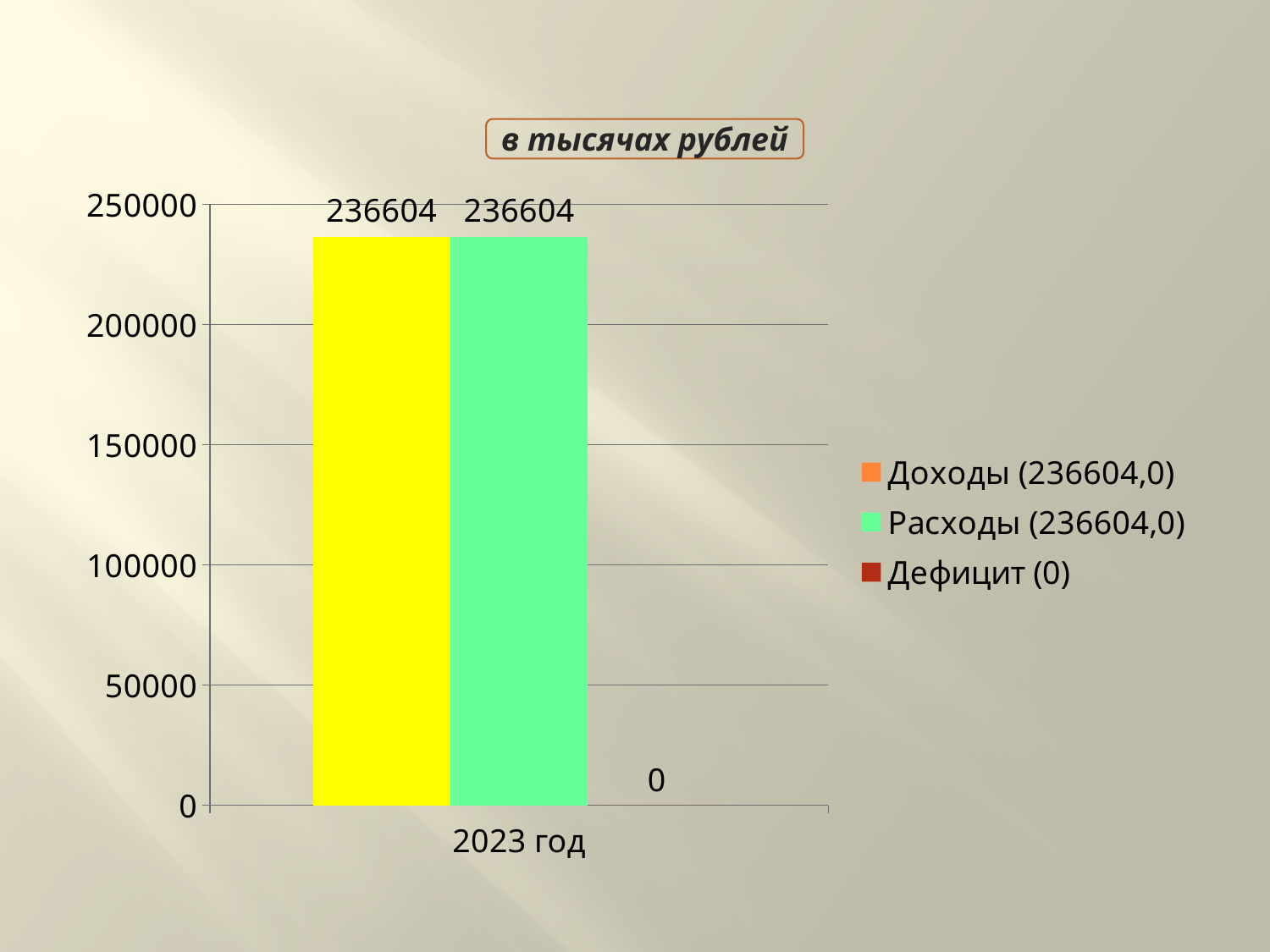
What is the difference between the values for Доходы and Расходы in 2023 год? 0 How many categories are shown on the x axis? 1 What is the value for Доходы in 2023 год? 236604 What kind of chart is shown on the slide? bar chart How many series does the legend list? 3 What is the value for Дефицит in 2023 год? 0 What is the title of the chart? в тысячах рублей Is the value for Расходы in 2023 год greater or less than 200000? greater Which is larger in 2023 год, Доходы or Дефицит? Доходы Which series has the lowest value in 2023 год? Дефицит What is the value for Расходы in 2023 год? 236604 What colour is the bar for Расходы? green